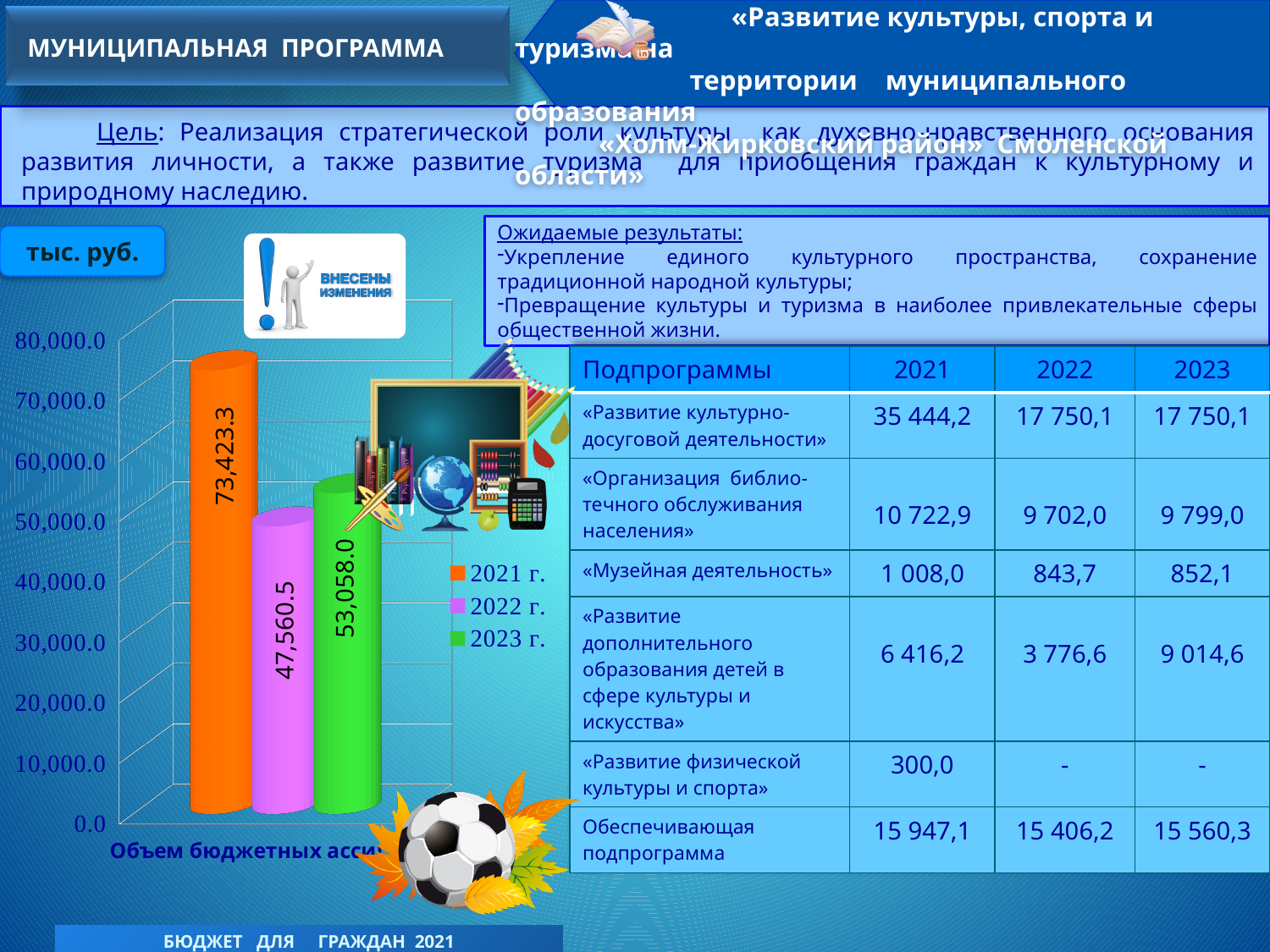
What is the value for 2021 г. in the bar chart? 73,423.3 Which year has the highest value in the bar chart? 2021 г. What is the value for 2023 г. in the bar chart? 53,058.0 What kind of chart is shown on the left of the slide? bar chart What is the difference between the values for 2021 г. and 2022 г. in the bar chart? 25,862.8 What is the difference between the values for 2023 г. and 2022 г. in the bar chart? 5,497.5 What is the value for 2022 г. in the bar chart? 47,560.5 Which is larger in the bar chart, the value for 2022 г. or 2023 г.? 2023 г. What unit is indicated for the values in the bar chart? тыс. руб. Which year has the lowest value in the bar chart? 2022 г. Is the value for 2021 г. in the bar chart greater or less than 70,000.0? greater How many series does the legend of the bar chart list? 3